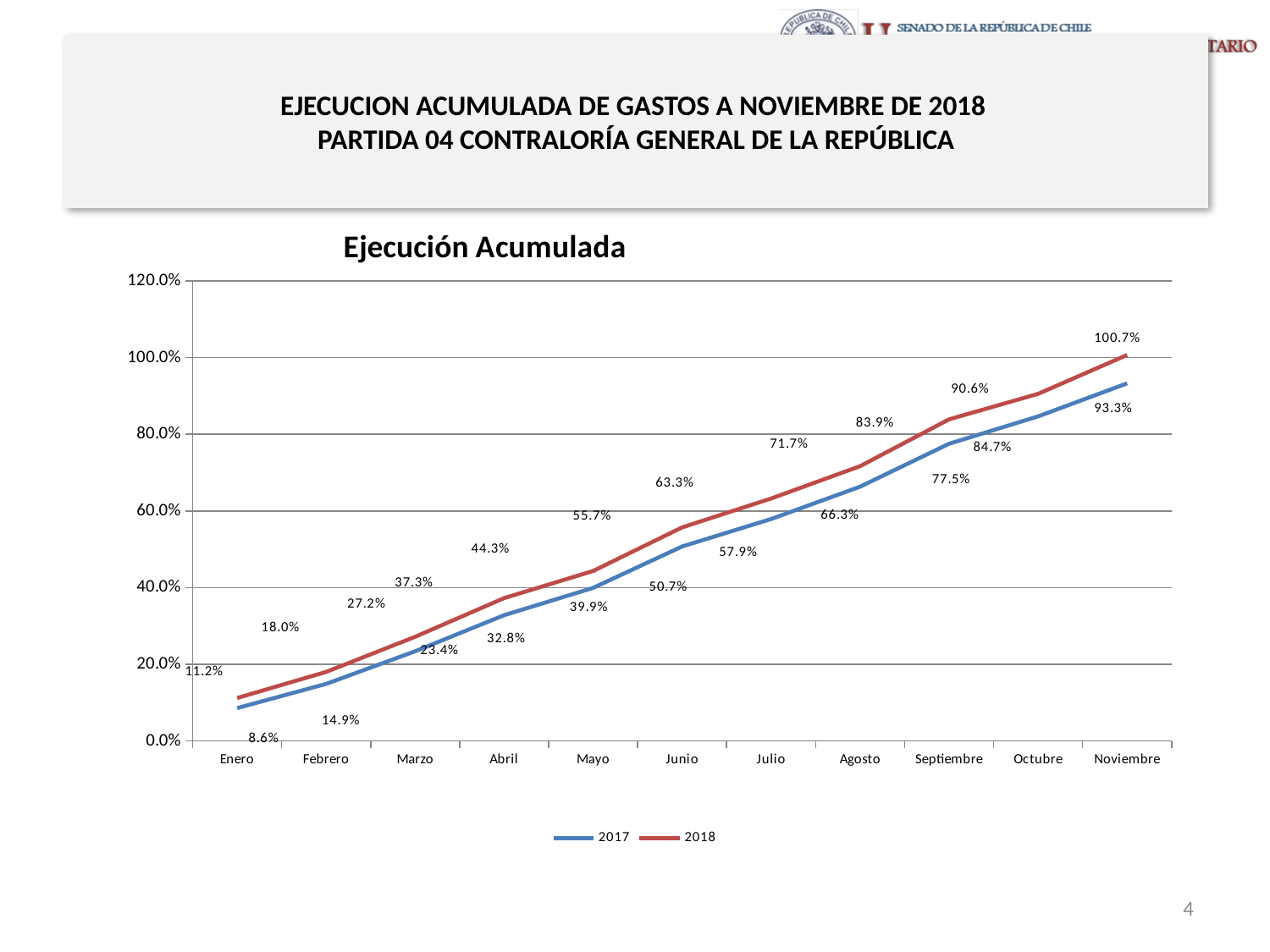
What is the value for 2017 in Septiembre? 77.5% Do the values of the 2017 series rise or fall from Enero to Noviembre? rise What is the value for 2018 in Junio? 55.7% Which is larger in Agosto, the 2017 value or the 2018 value? 2018 What type of chart is shown on the slide? line chart In which month is the 2018 series at its lowest value? Enero How many months are plotted along the x axis? 11 What is the value for 2018 in Noviembre? 100.7% What is the difference between the 2018 and 2017 values in Noviembre? 7.4% What is the value for 2017 in Enero? 8.6% What is the title of the chart? Ejecución Acumulada How many series does the legend list? 2